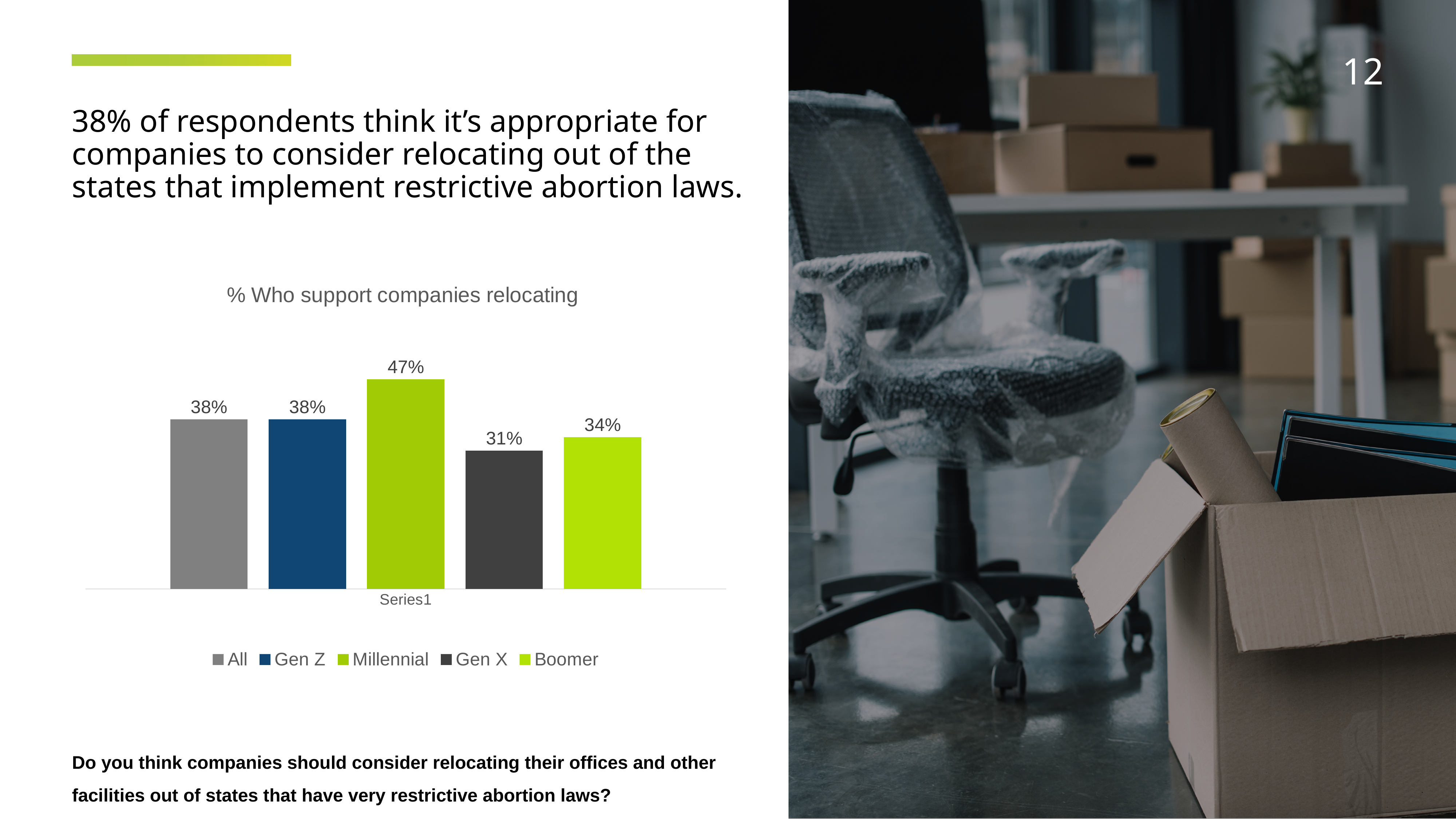
How many series does the legend list? 5 Which is larger, the value for Gen Z or the value for Boomer? Gen Z Which group has the highest share supporting companies relocating? Millennial What is the value for Gen X in the chart? 31% What is the difference between the Boomer value and the Gen X value? 3% What is the title of the chart? % Who support companies relocating What kind of chart is shown on the slide? Bar chart What is the value for Gen Z in the chart? 38% Which group has the lowest share supporting companies relocating? Gen X What is the value for Millennial in the chart? 47% What is the value for Boomer in the chart? 34% What is the difference between the Millennial value and the Gen X value? 16%